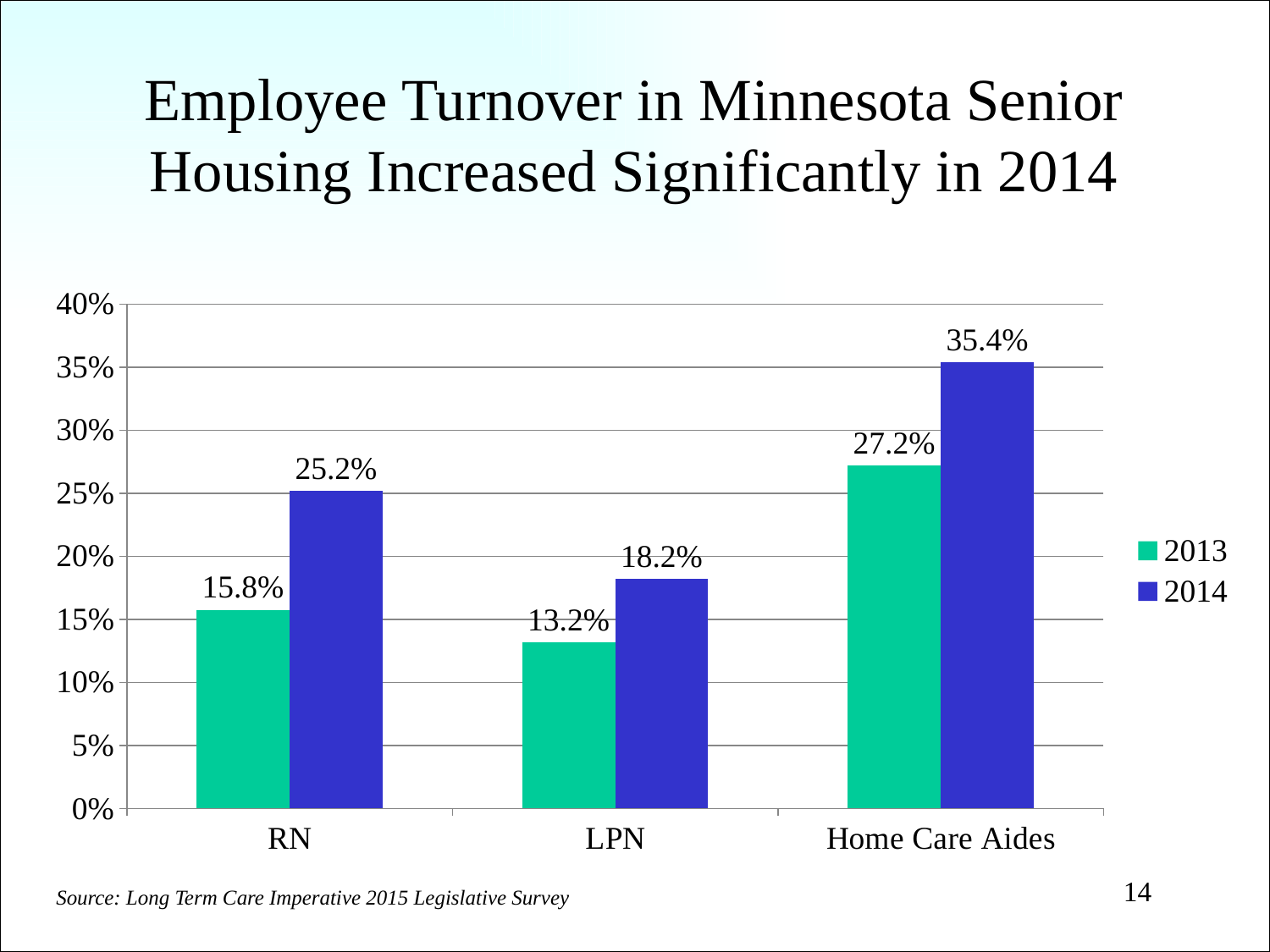
Which category has the lowest 2013 turnover rate? LPN What was the 2014 turnover rate for RN? 25.2% What is the difference between the 2014 and 2013 turnover rates for Home Care Aides? 8.2% How many series does the legend list? 2 What kind of chart is shown on the slide? Bar chart Is the 2014 turnover rate for Home Care Aides greater or less than 30%? greater Which category has the highest 2014 turnover rate? Home Care Aides Which is larger, the 2014 turnover rate for LPN or the 2013 turnover rate for RN? 2014 turnover rate for LPN How many job categories are shown on the x axis? 3 What is the difference between the 2014 and 2013 turnover rates for RN? 9.4% What was the 2013 turnover rate for LPN? 13.2% What was the 2013 turnover rate for Home Care Aides? 27.2%